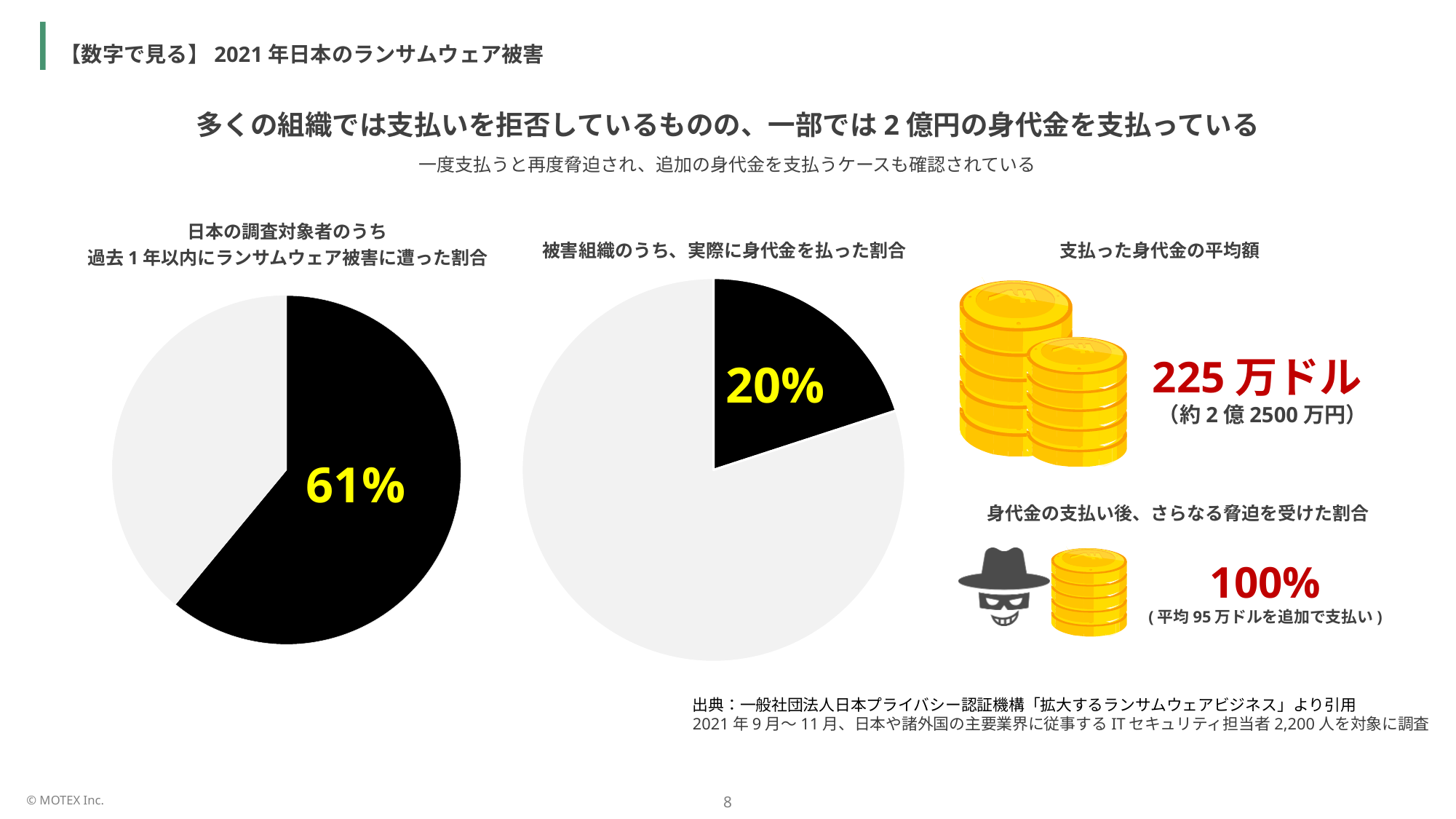
In the left pie chart (被害に遭った割合), is the black slice greater or less than 50% of the pie? greater In the left pie chart, what share of the pie does the black slice represent? 61% What is the difference between the labelled percentage in the left pie chart (61%) and the labelled percentage in the right pie chart (20%)? 41% How many slices does the right pie chart (実際に身代金を払った割合) have? 2 What kind of chart is used for 被害組織のうち、実際に身代金を払った割合? Pie chart In the right pie chart (身代金を払った割合), is the black slice greater or less than 50% of the pie? less In the right pie chart (被害組織のうち、実際に身代金を払った割合), what percentage is shown for the black slice? 20% In the left pie chart (日本の調査対象者のうち過去1年以内にランサムウェア被害に遭った割合), what percentage is shown for the black slice? 61% How many pie charts are shown on the slide? 2 Which pie chart has the larger black slice, the left one (被害に遭った割合) or the right one (身代金を払った割合)? The left one (被害に遭った割合) What kind of chart is used for 日本の調査対象者のうち過去1年以内にランサムウェア被害に遭った割合? Pie chart How many slices does the left pie chart (ランサムウェア被害に遭った割合) have? 2